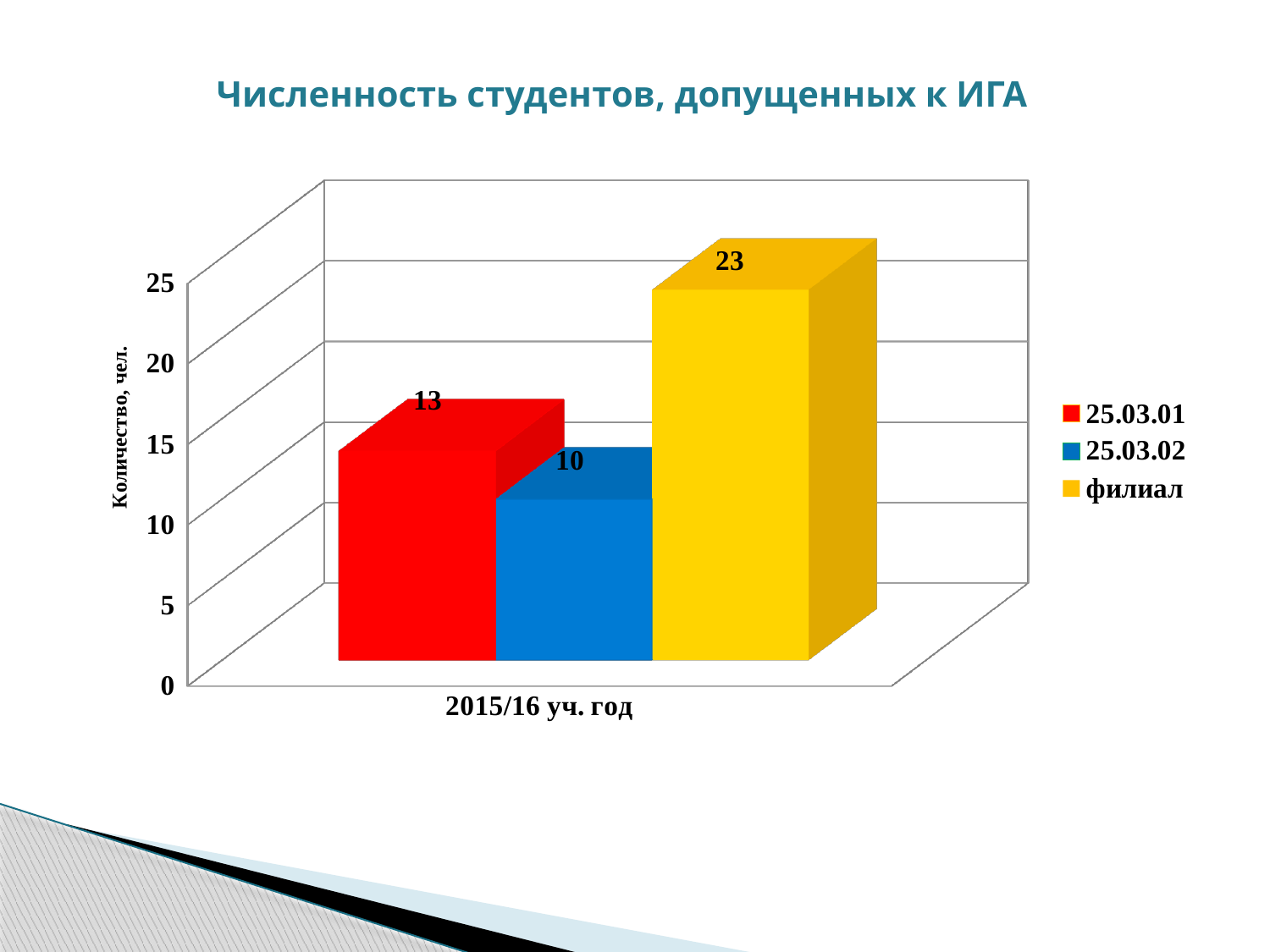
Is the value for филиал greater or less than 20? greater Which is larger, the value for 25.03.01 or the value for 25.03.02? 25.03.01 Which series has the highest value? филиал What is the value for 25.03.02 in 2015/16 уч. год? 10 Which series has the lowest value? 25.03.02 How many series does the legend list? 3 What is the title of the chart? Численность студентов, допущенных к ИГА What is the difference between the values for филиал and 25.03.01? 10 What kind of chart is shown on the slide? bar chart What is the value for филиал in 2015/16 уч. год? 23 What is the value for 25.03.01 in 2015/16 уч. год? 13 What is the difference between the values for 25.03.01 and 25.03.02? 3